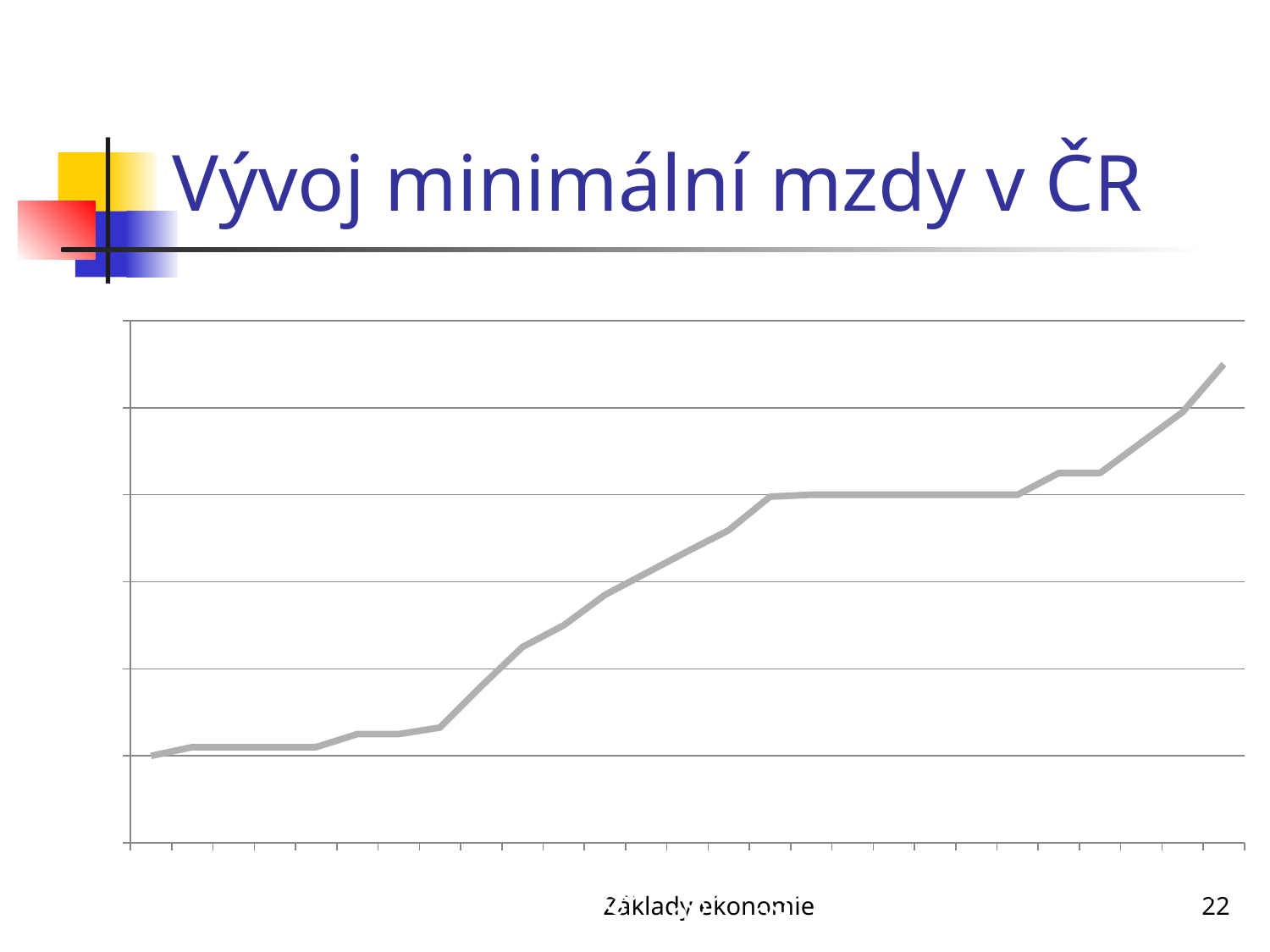
Do the values in the chart rise or fall overall from left to right along the x axis? rise At which end of the x axis does the line reach its highest value, the left end or the right end? right end How many lines (data series) are plotted in the chart? 1 What is the title of the slide containing the chart? Vývoj minimální mzdy v ČR What kind of chart is shown on the slide? line chart Is the value at the right end of the line higher or lower than the value at the left end? higher At which end of the x axis does the line have its lowest value, the left end or the right end? left end Does the chart display a legend? No